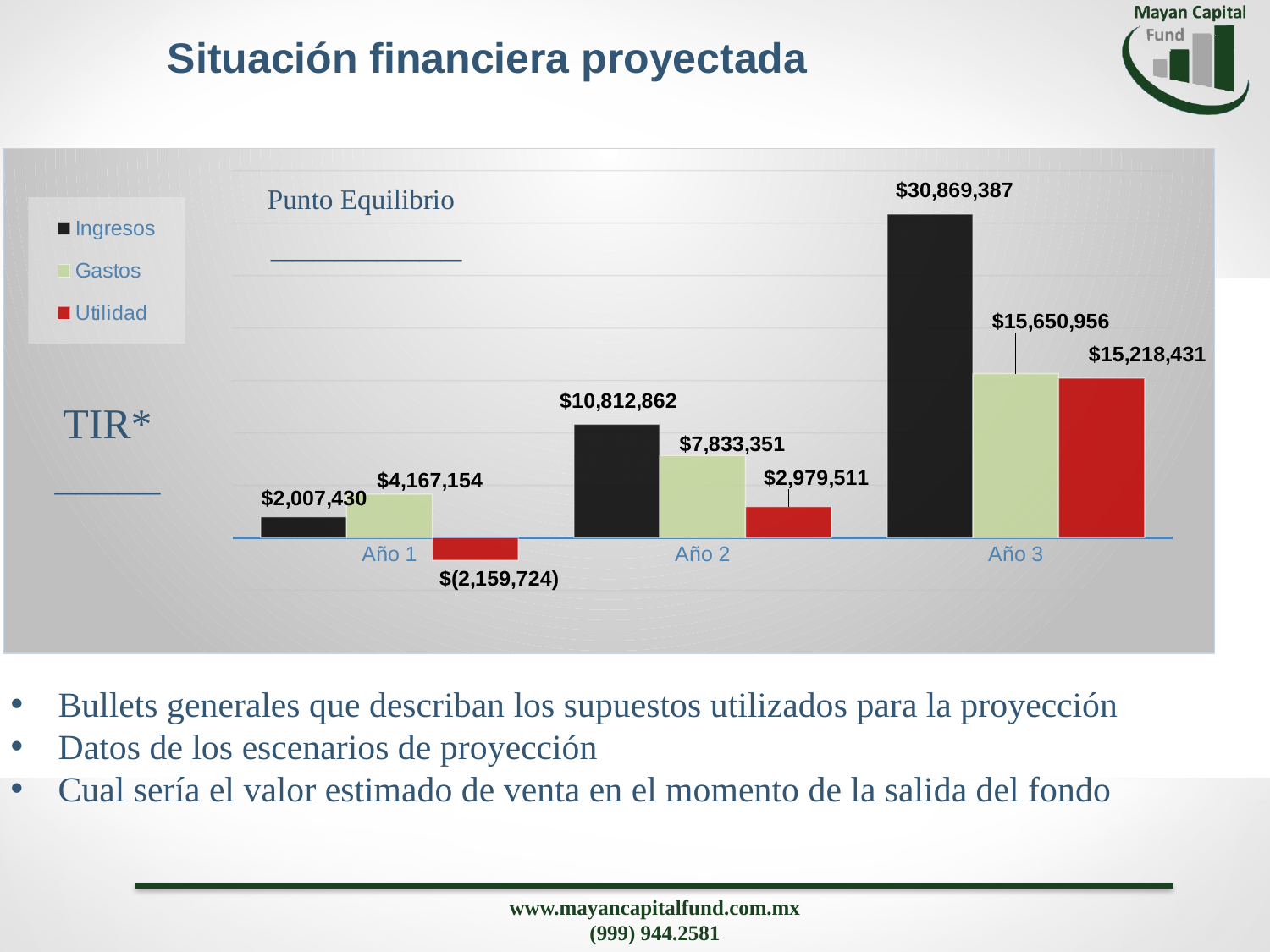
What is the value of Gastos for Año 1? $4,167,154 In which year is Utilidad lowest? Año 1 What type of chart is shown on the slide? Bar chart What is the value of Ingresos for Año 3? $30,869,387 Which is larger in Año 1, Ingresos or Gastos? Gastos How many year categories are shown on the x axis of the chart? 3 What is the value of Gastos for Año 2? $7,833,351 What is the value of Utilidad for Año 1? $(2,159,724) How many series does the chart legend list? 3 What is the difference between Ingresos in Año 3 and Ingresos in Año 2? $20,056,525 Do the Ingresos values rise or fall from Año 1 to Año 3? Rise In which year is Ingresos highest? Año 3